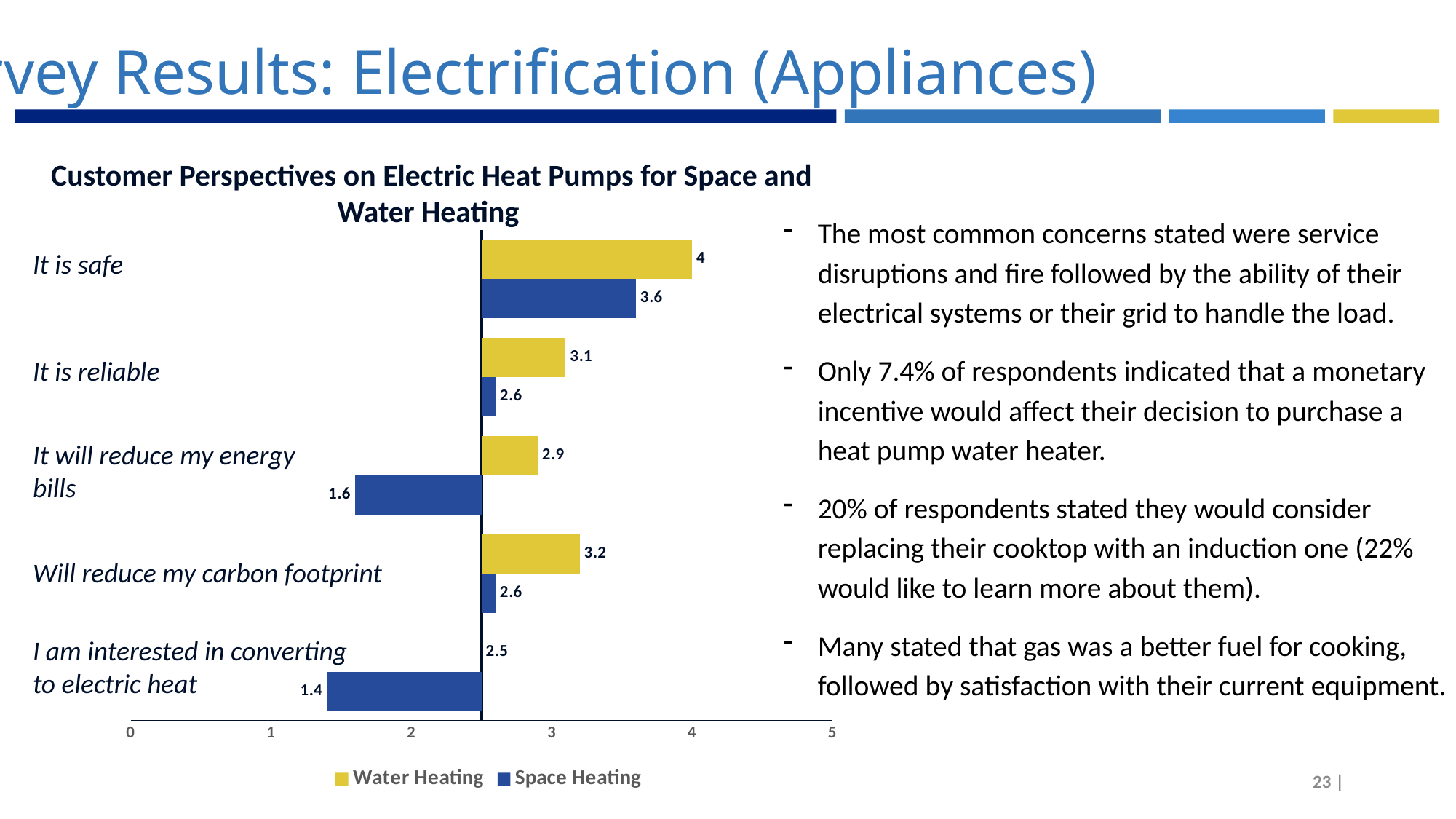
Which category has the lowest Space Heating value? I am interested in converting to electric heat What kind of chart is shown on the slide? Bar chart What is the Space Heating value for "I am interested in converting to electric heat"? 1.4 How many categories are shown on the chart? 5 What is the Space Heating value for "It will reduce my energy bills"? 1.6 For "It is safe", which is larger: the Water Heating value or the Space Heating value? Water Heating Which colour represents the Space Heating series? Blue What is the Water Heating value for "Will reduce my carbon footprint"? 3.2 Which category has the highest Water Heating value? It is safe What is the difference between the Water Heating and Space Heating values for "It is reliable"? 0.5 How many series does the legend list? 2 What is the Water Heating value for "It is safe"? 4